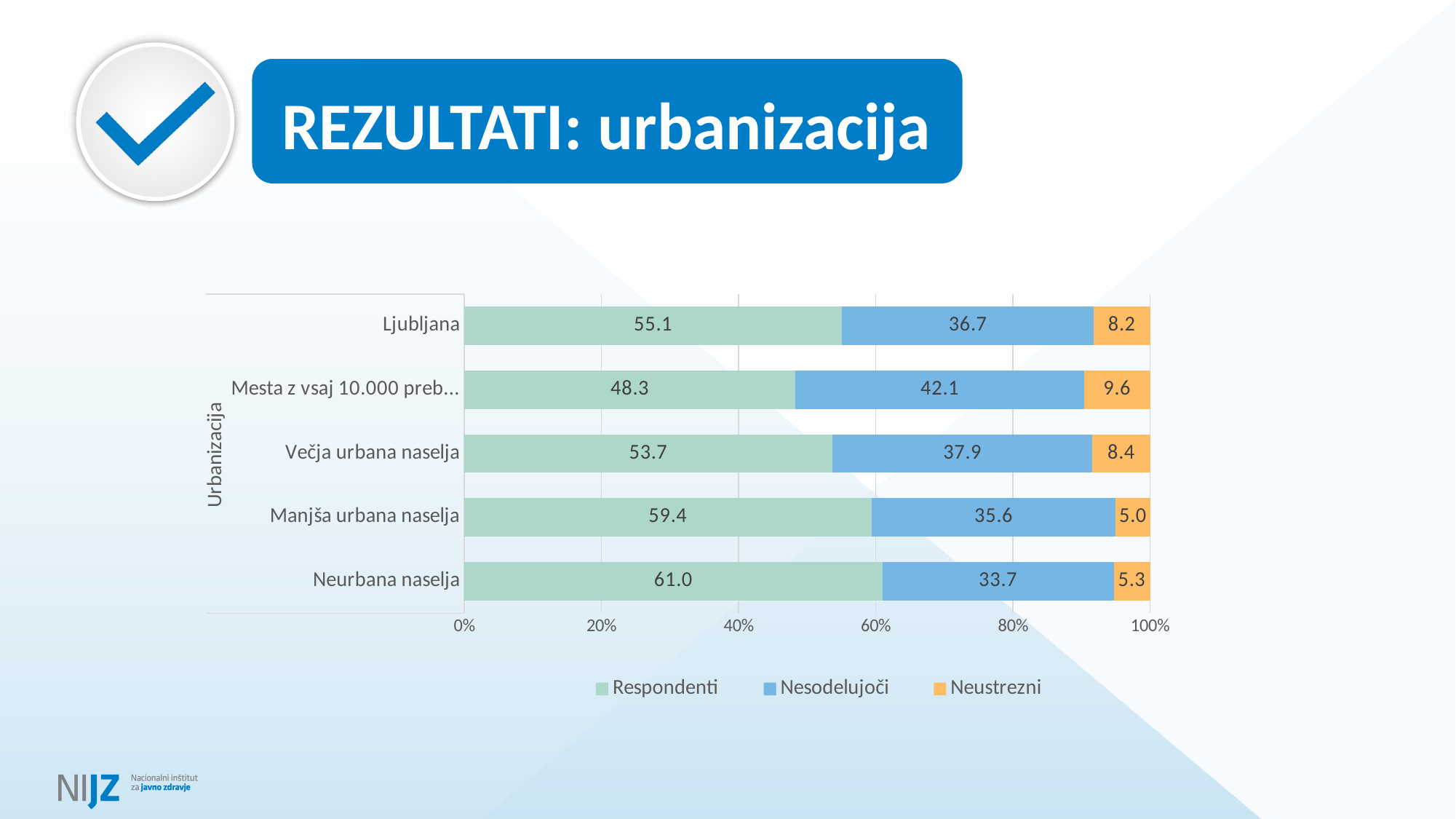
Which category has the highest Neustrezni value? Mesta z vsaj 10.000 preb… What is the label of the vertical axis? Urbanizacija What is the Neustrezni value for Manjša urbana naselja? 5.0 What is the Nesodelujoči value for Mesta z vsaj 10.000 preb…? 42.1 Which category has the highest Respondenti value? Neurbana naselja Which is larger: the Nesodelujoči value for Ljubljana or for Večja urbana naselja? Večja urbana naselja How many categories are shown on the y axis? 5 What kind of chart is shown on the slide? Stacked bar chart What is the difference between the Respondenti values for Neurbana naselja and Ljubljana? 5.9 Which category has the lowest Respondenti value? Mesta z vsaj 10.000 preb… How many series does the legend list? 3 What is the Respondenti value for Ljubljana? 55.1